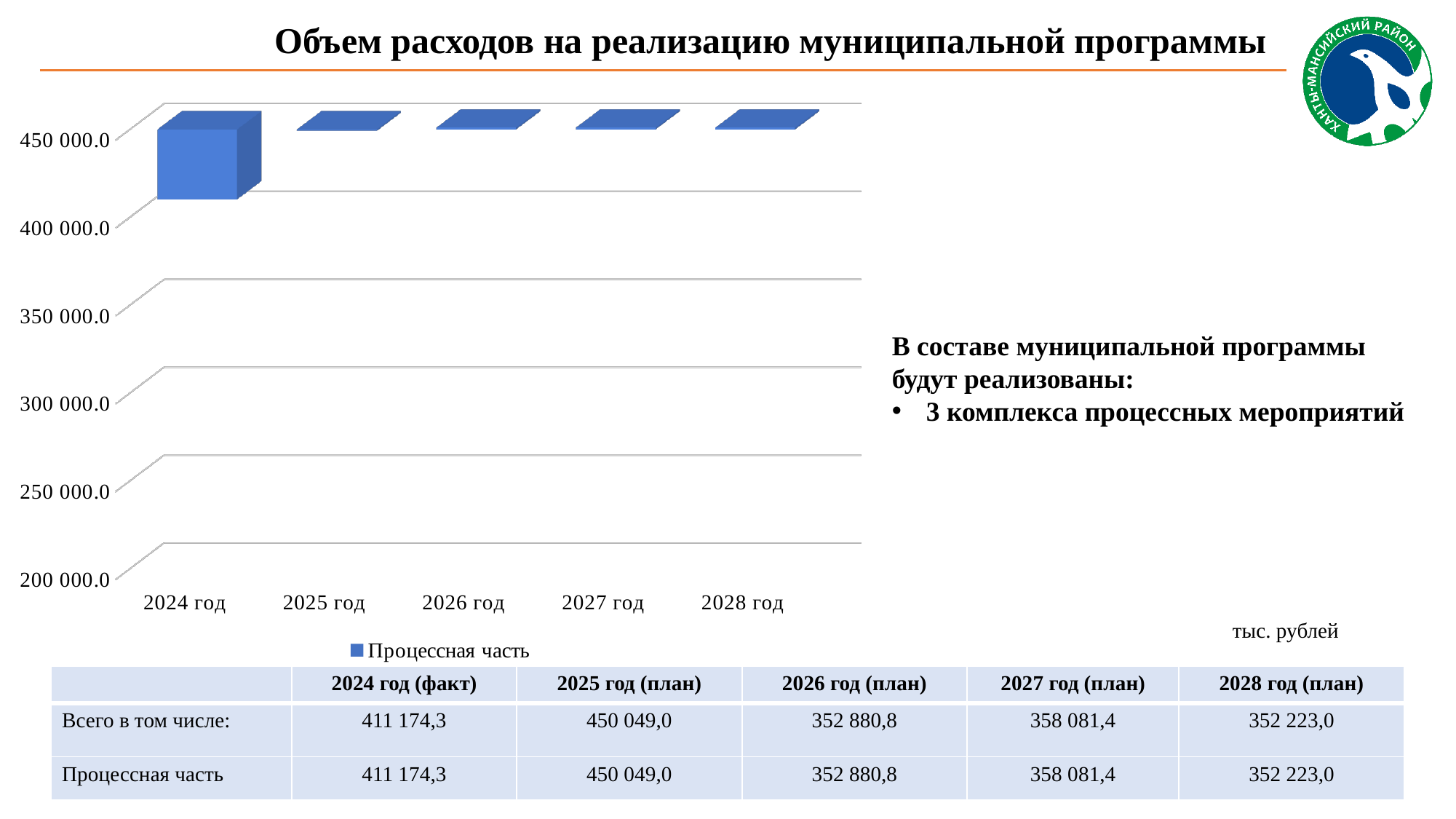
According to the table below the chart, which year has the lowest value of Процессная часть? 2028 год What kind of chart is shown on the slide? bar chart According to the table below the chart, what is the value of Процессная часть for 2025 год (план)? 450 049,0 What is the name of the series shown in the chart legend? Процессная часть According to the table below the chart, what is the difference between the values for 2025 год and 2024 год? 38 874,7 According to the table below the chart, which year has the highest value of Процессная часть? 2025 год How many year categories are shown on the x axis of the chart? 5 According to the table below the chart, which is larger: the value for 2026 год or 2027 год? 2027 год What is the title of the chart on the slide? Объем расходов на реализацию муниципальной программы According to the table below the chart, what is the value of Процессная часть for 2024 год (факт)? 411 174,3 How many series does the chart legend list? 1 According to the table below the chart, what is the value of Процессная часть for 2028 год (план)? 352 223,0